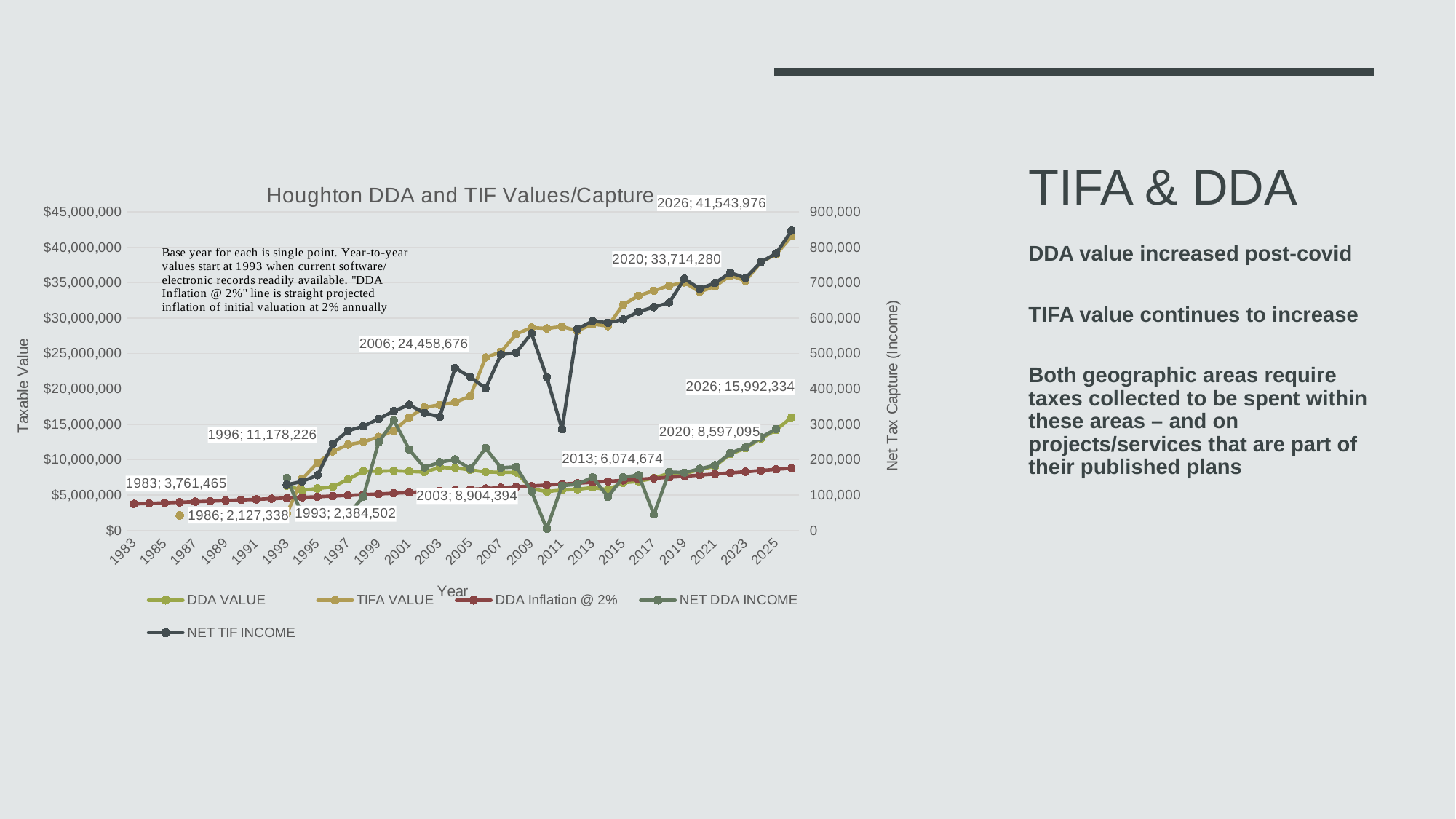
What kind of chart is shown on the slide? line chart By how much does the TIFA VALUE increase from 2020 to 2026? 7,829,696 What is the DDA VALUE for 2013? 6,074,674 Which is larger in 2026, the TIFA VALUE or the DDA VALUE? TIFA VALUE Does the TIFA VALUE generally rise or fall from 1983 to 2026? rise What is the TIFA VALUE for 2020? 33,714,280 What is the DDA VALUE for 2026? 15,992,334 Is the TIFA VALUE for 2010 greater or less than $25,000,000? greater What is the TIFA VALUE for 2026? 41,543,976 What is the title of the chart? Houghton DDA and TIF Values/Capture What is the DDA VALUE for 2020? 8,597,095 How many series does the legend list? 5